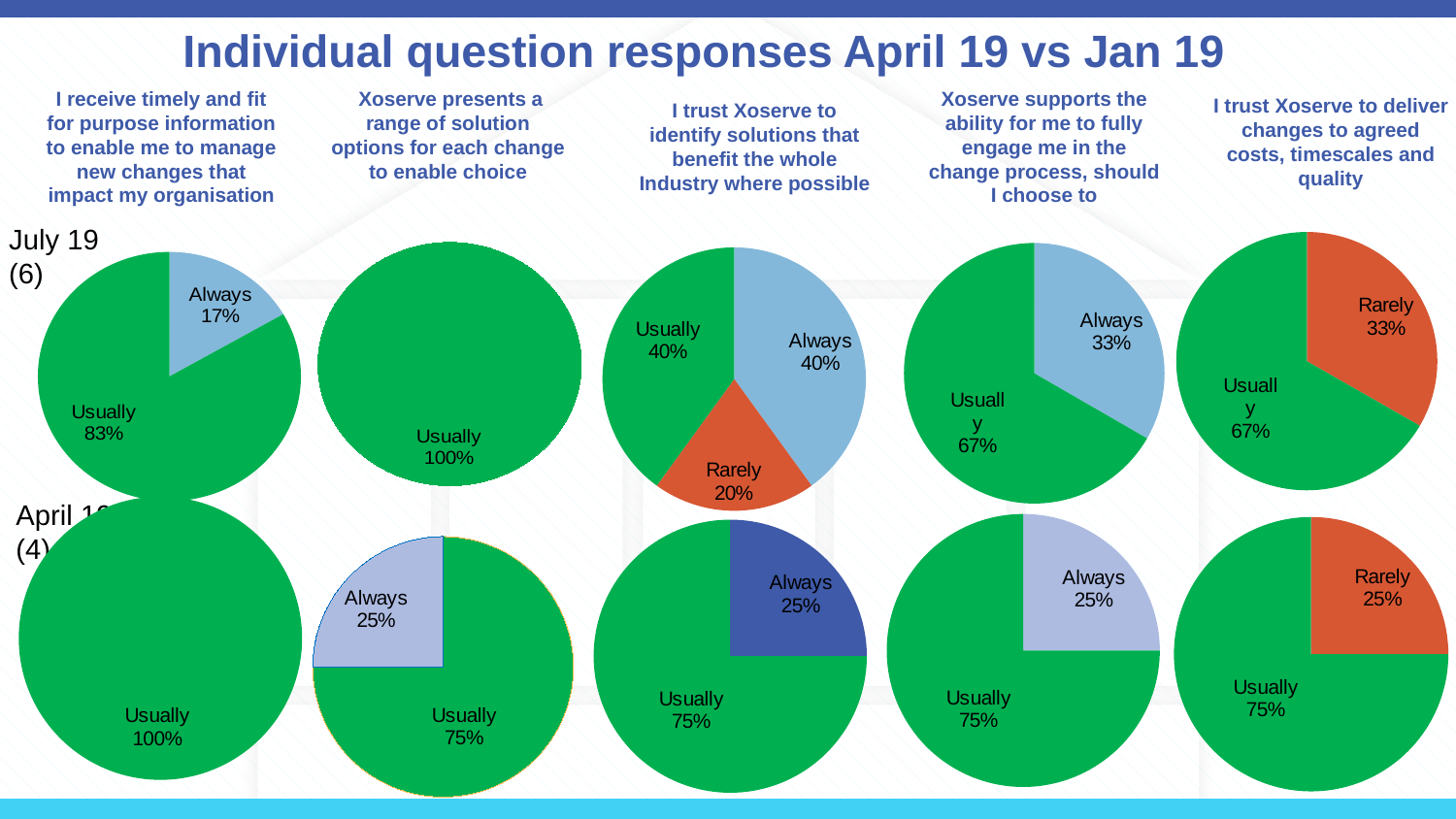
What kind of charts are shown on the slide? Pie charts In the April 19 pie chart for "I receive timely and fit for purpose information to enable me to manage new changes that impact my organisation", what share of responses is "Usually"? 100% How many pie charts are shown on the slide in total? 10 In the July 19 pie chart for "Xoserve supports the ability for me to fully engage me in the change process, should I choose to", what share of responses is "Always"? 33% In the April 19 pie chart for "I trust Xoserve to deliver changes to agreed costs, timescales and quality", what share of responses is "Rarely"? 25% In the April 19 pie chart for "Xoserve presents a range of solution options for each change to enable choice", what is the difference between the "Usually" share and the "Always" share? 50% In the July 19 pie chart for "I trust Xoserve to deliver changes to agreed costs, timescales and quality", which response category has the largest share? Usually How many slices does the July 19 pie chart for "I trust Xoserve to identify solutions that benefit the whole Industry where possible" have? 3